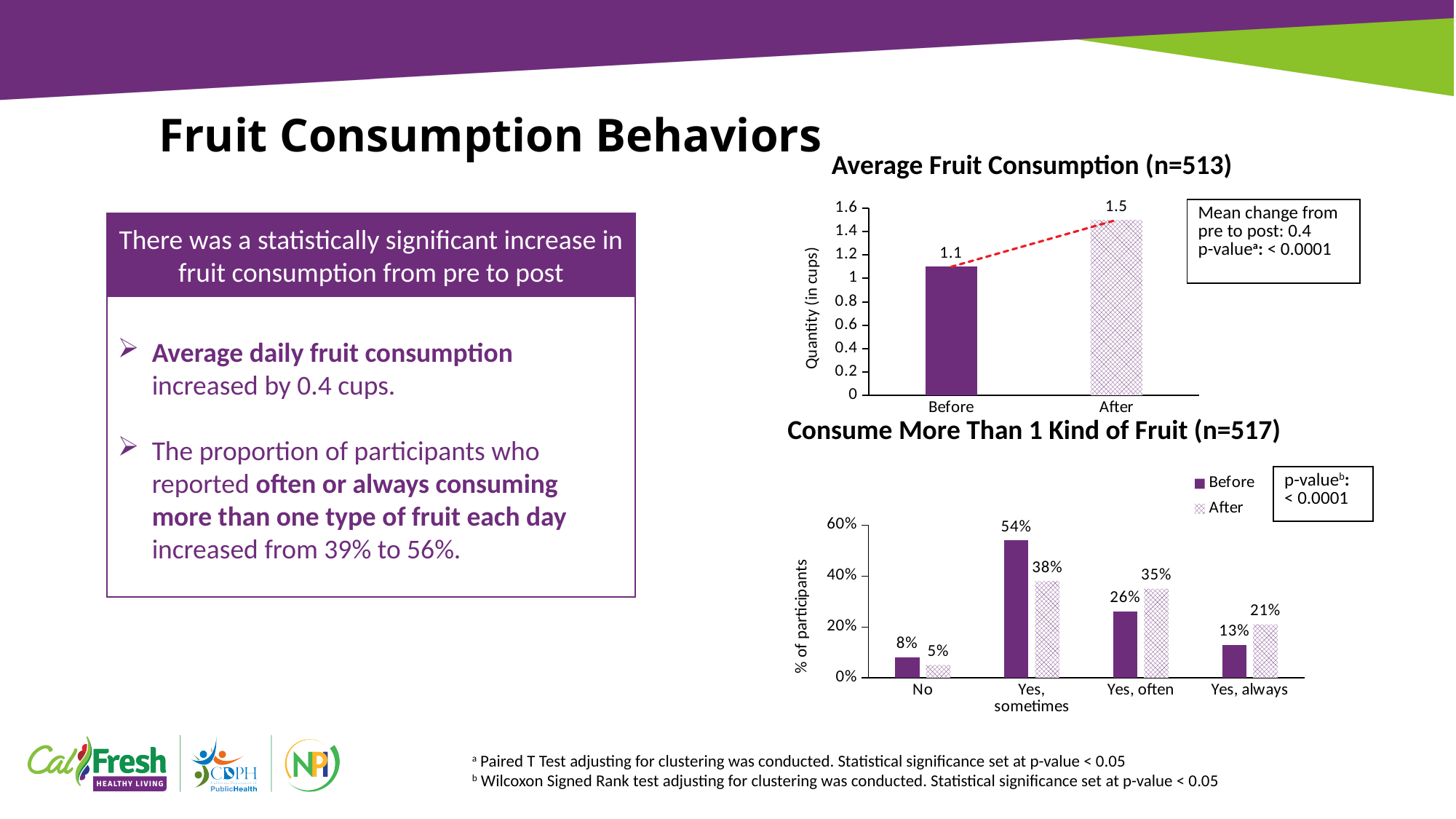
In the 'Average Fruit Consumption (n=513)' chart, what is the difference between the After and Before values? 0.4 In the 'Consume More Than 1 Kind of Fruit (n=517)' chart, what is the After value for 'Yes, always'? 21% In the 'Consume More Than 1 Kind of Fruit (n=517)' chart, what is the Before value for 'Yes, sometimes'? 54% In the 'Average Fruit Consumption (n=513)' chart, what is the value for After? 1.5 In the 'Average Fruit Consumption (n=513)' chart, what is the y-axis label? Quantity (in cups) In the 'Average Fruit Consumption (n=513)' chart, what kind of chart is shown? Bar chart In the 'Average Fruit Consumption (n=513)' chart, what is the value for Before? 1.1 In the 'Consume More Than 1 Kind of Fruit (n=517)' chart, how many categories are shown on the x-axis? 4 In the 'Consume More Than 1 Kind of Fruit (n=517)' chart, what is the difference between the After and Before values for 'Yes, often'? 9% In the 'Consume More Than 1 Kind of Fruit (n=517)' chart, which category has the lowest After value? No In the 'Consume More Than 1 Kind of Fruit (n=517)' chart, how many series does the legend list? 2 In the 'Consume More Than 1 Kind of Fruit (n=517)' chart, which category has the highest Before value? Yes, sometimes